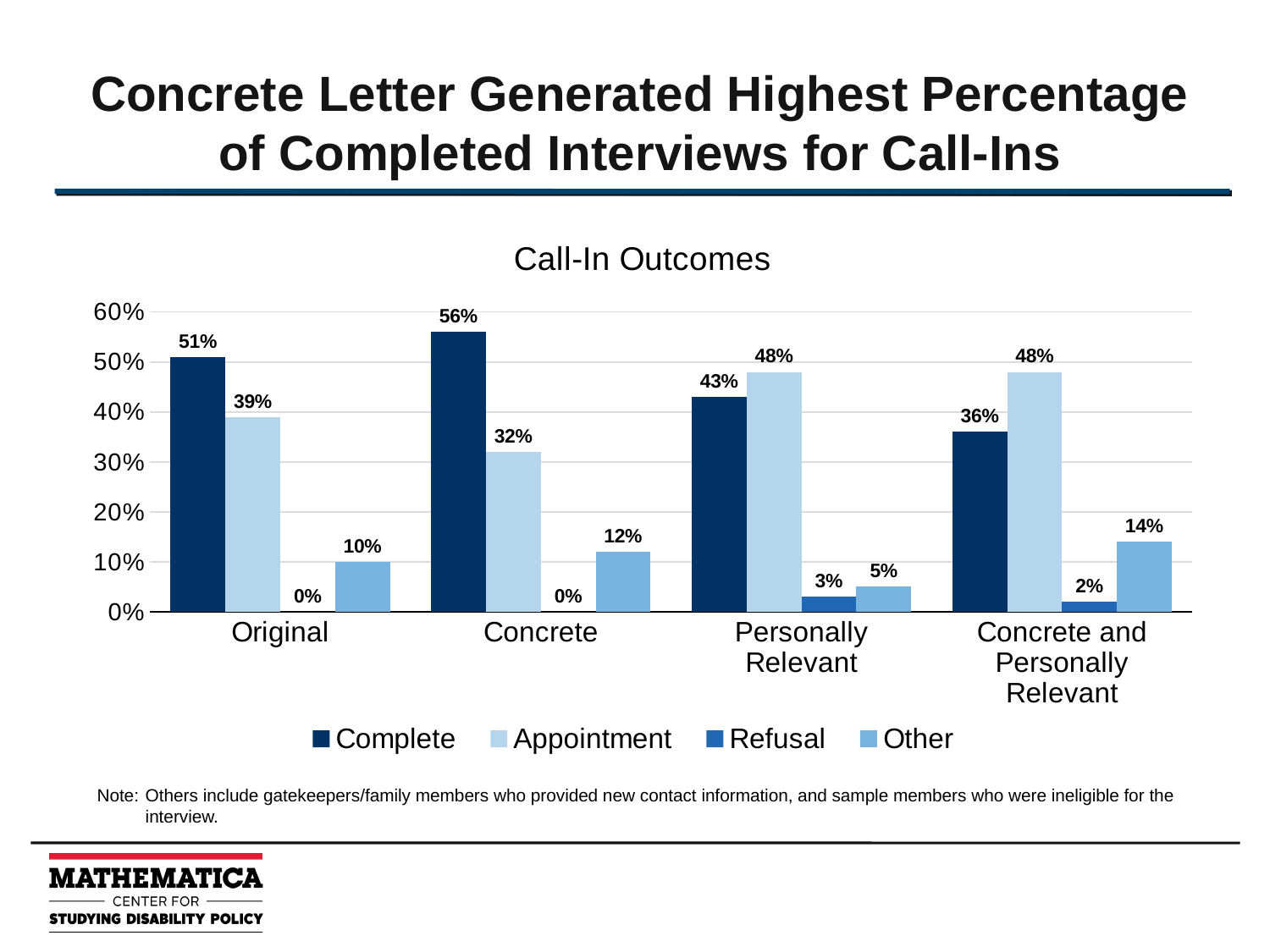
How many letter types are shown on the x axis? 4 How many series does the legend list? 4 What is the difference between the Complete values for Concrete and Original? 5% Which letter type has the lowest Complete percentage? Concrete and Personally Relevant What kind of chart is shown? Bar chart What is the title of the chart? Call-In Outcomes What is the Appointment value for the Original letter? 39% Which is larger for the Personally Relevant letter, Complete or Appointment? Appointment Which letter type has the highest Complete percentage? Concrete What is the Other value for the Concrete and Personally Relevant letter? 14% What is the Complete value for the Concrete letter? 56% What is the Refusal value for the Personally Relevant letter? 3%